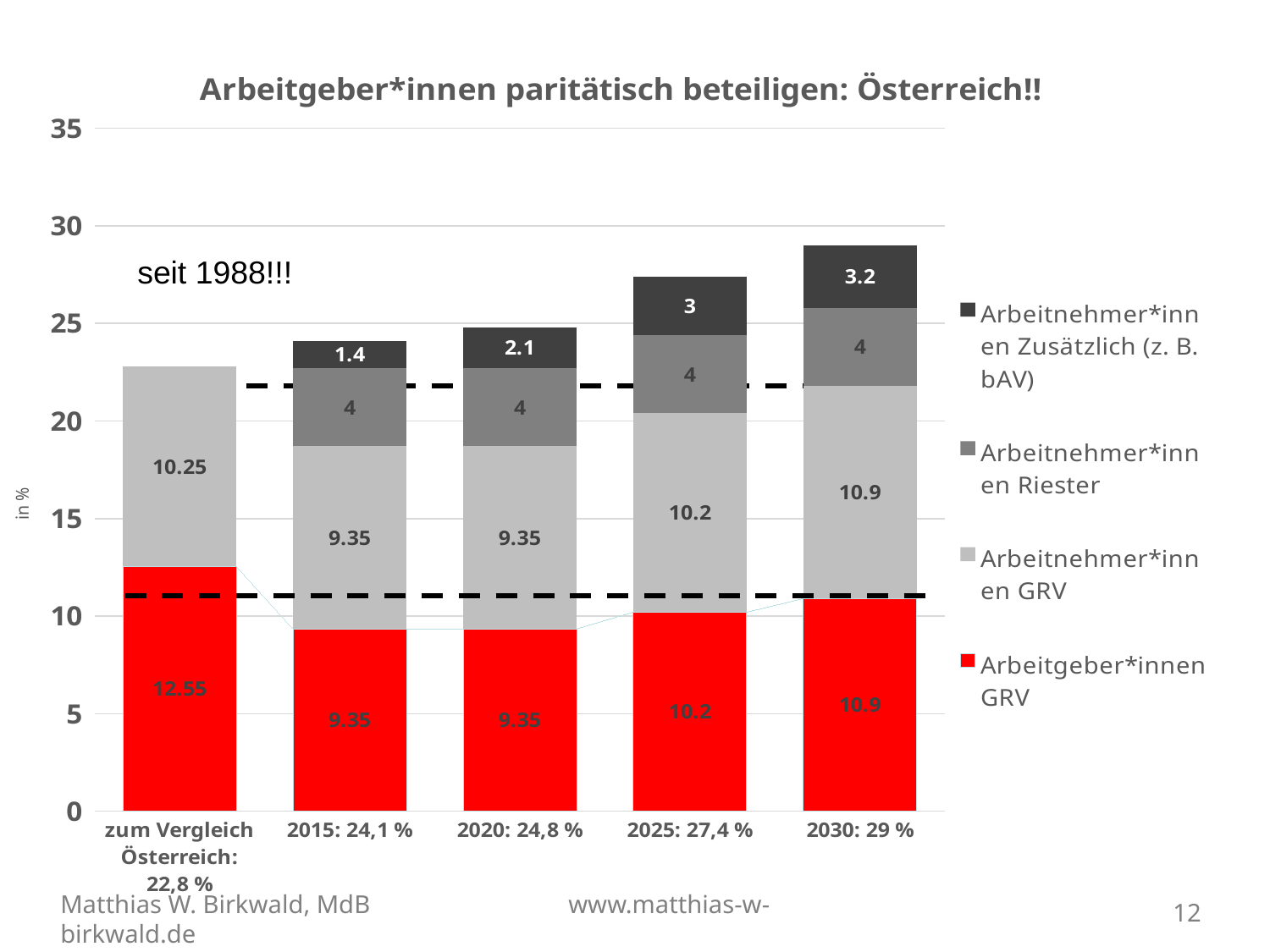
How many series does the legend list? 4 What is the Arbeitgeber*innen GRV value for the 'zum Vergleich Österreich: 22,8 %' bar? 12.55 What is the Arbeitnehmer*innen Zusätzlich (z. B. bAV) value for 2030? 3.2 What kind of chart is shown on the slide? stacked bar chart What is the difference between the Arbeitgeber*innen GRV value for Österreich (12.55) and for 2015 (9.35)? 3.2 How many bars (categories) are shown on the x axis? 5 Which category has the highest Arbeitgeber*innen GRV value? zum Vergleich Österreich: 22,8 % What is the title of the chart? Arbeitgeber*innen paritätisch beteiligen: Österreich!! Which category has the lowest Arbeitnehmer*innen Zusätzlich (z. B. bAV) value among those that have one? 2015: 24,1 % What is the Arbeitnehmer*innen Riester value for 2025? 4 What is the total of the stacked bar for 2025? 27.4 Is the Arbeitgeber*innen GRV value for 2030 larger or smaller than for 2020? larger